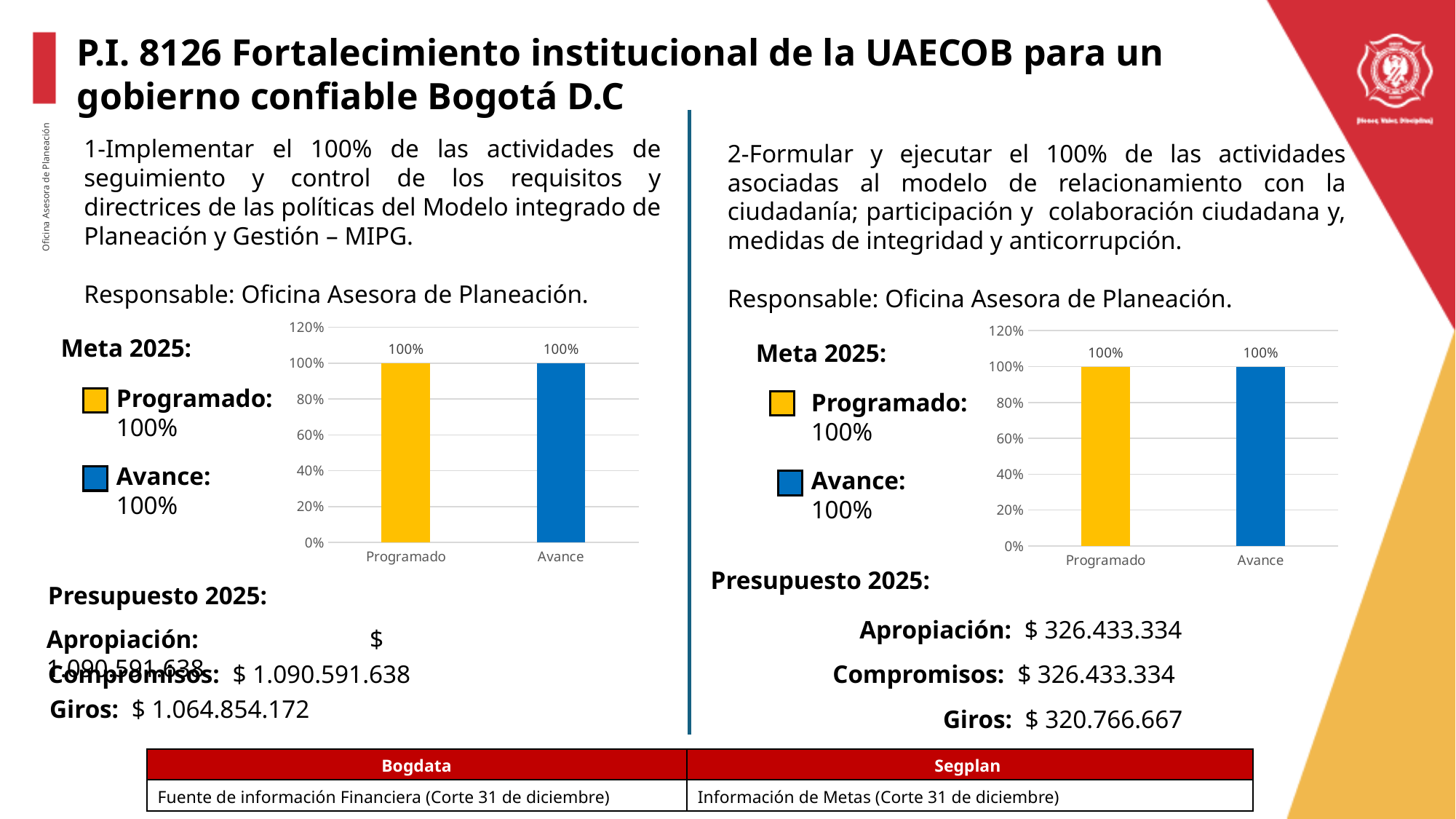
In the left chart, is the value for Programado greater or less than 60%? greater In the right chart, what is the value for Programado? 100% What kind of chart is the left chart? bar chart What is the highest value shown on the y axis of the right chart? 120% In the left chart, what colour is the Programado bar? yellow In the left chart, what is the difference between the Programado and Avance values? 0% In the left chart, what is the value for Avance? 100% In the right chart, what is the value for Avance? 100% In the right chart, is the value for Avance greater or less than 80%? greater How many categories are shown on the x axis of the right chart? 2 How many categories are shown on the x axis of the left chart? 2 In the left chart, what is the value for Programado? 100%